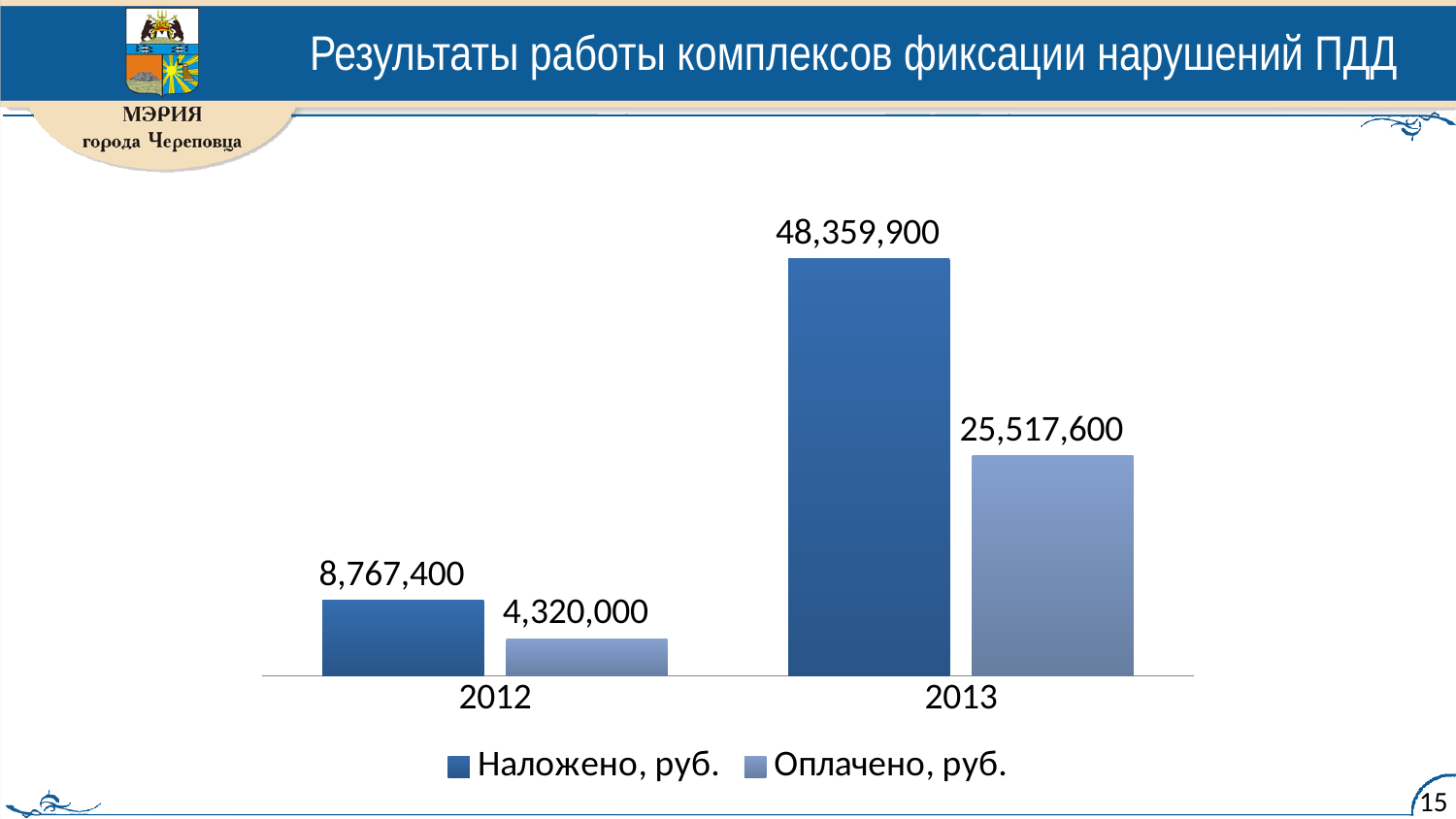
What is the value of Оплачено, руб. for 2012? 4,320,000 What is the value of Наложено, руб. for 2013? 48,359,900 How many years are shown on the x axis? 2 Which year has the highest value for Наложено, руб.? 2013 Which bar has the lowest value on the chart? Оплачено, руб. for 2012 What is the value of Оплачено, руб. for 2013? 25,517,600 What is the value of Наложено, руб. for 2012? 8,767,400 What kind of chart is shown on the slide? Bar chart By how much did Наложено, руб. increase from 2012 to 2013? 39,592,500 How many series does the legend list? 2 Which is larger: Оплачено, руб. in 2013 or Наложено, руб. in 2012? Оплачено, руб. in 2013 What is the difference between Наложено, руб. and Оплачено, руб. in 2013? 22,842,300